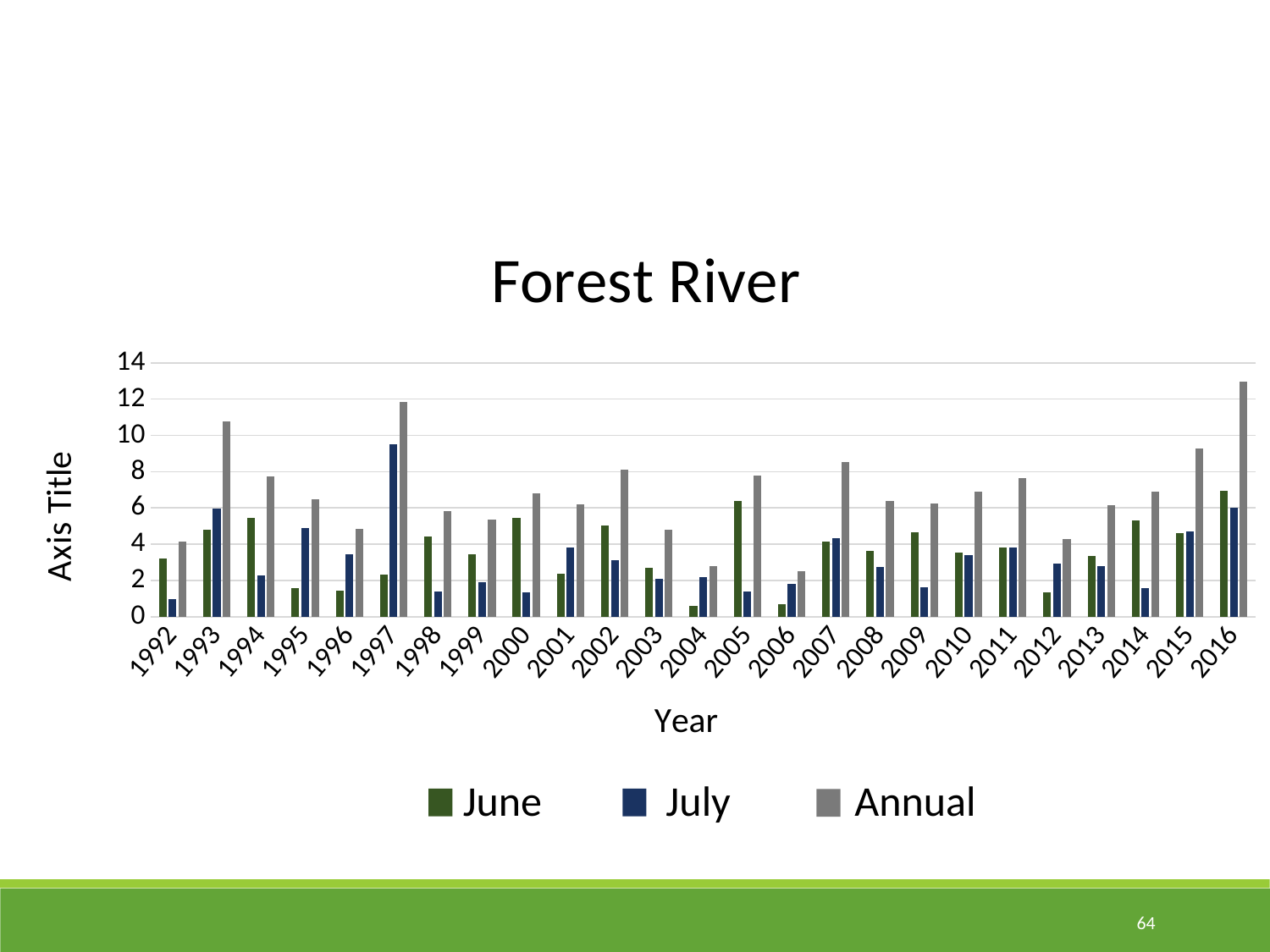
Which year has the lowest July value? 1992 Which year has the highest July value? 1997 Which year has the highest Annual value? 2016 What kind of chart is shown on the slide? bar chart How many series does the legend list? 3 How many years are shown on the x axis? 25 Is the June value for 2004 greater or less than 2? less Is the July value for 1995 greater or less than 4? greater Is the Annual value for 1997 greater or less than 10? greater Which is larger, the Annual value for 2006 or the Annual value for 2007? 2007 What is the title of the chart? Forest River Which is larger in 1994, the June value or the July value? June